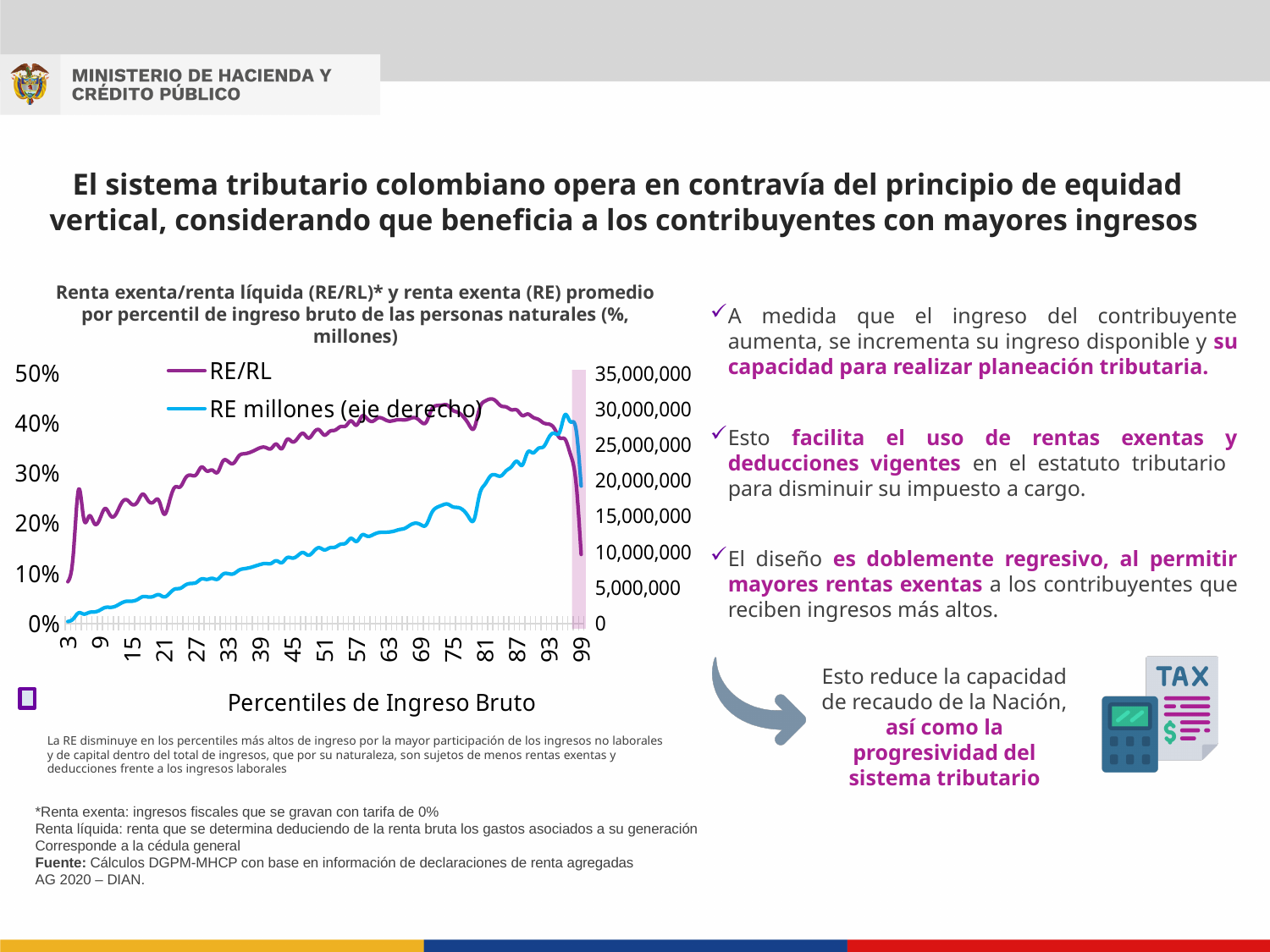
What is the title of the x axis of the chart? Percentiles de Ingreso Bruto Is the RE/RL value at percentile 51 greater or less than 30%? greater Is the RE millones value at percentile 15 greater or less than 5,000,000? less How many series does the chart legend list? 2 Is the RE/RL value at percentile 75 greater or less than 30%? greater What kind of chart is shown on the slide? line chart Which series in the chart is plotted on the right-hand axis (eje derecho)? RE millones Does the RE millones series generally rise or fall as the percentile increases from 3 to 93? rise Which is larger for the RE/RL series: the value at percentile 51 or the value at percentile 9? percentile 51 Does the RE/RL series rise or fall between percentile 93 and percentile 99? fall Which is larger for the RE millones series: the value at percentile 81 or the value at percentile 27? percentile 81